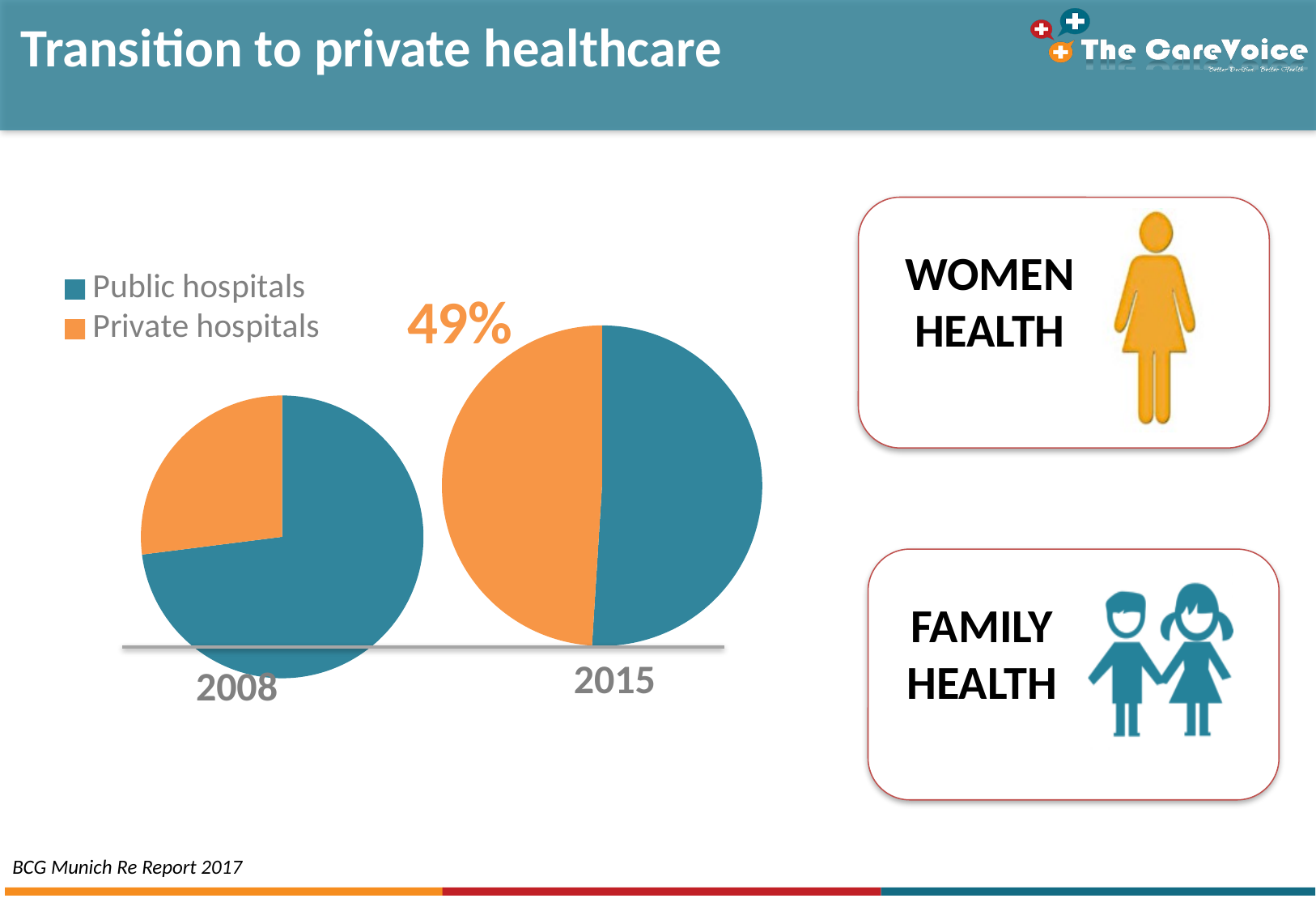
In the 2015 pie chart, what share is labelled for private hospitals? 49% Which colour represents private hospitals in the pie charts? Orange In the 2008 pie chart, which category has the smallest slice? Private hospitals Does the share of private hospitals rise or fall from 2008 to 2015? Rise Which year's pie chart carries the 49% label? 2015 How many pie charts are on the slide? 2 What kind of charts are shown on the slide? Pie charts How many series does the legend list? 2 In the 2015 pie chart, what share do public hospitals account for, given the private hospitals label? 51% Is the private hospitals share larger in the 2008 pie chart or the 2015 pie chart? 2015 In the 2008 pie chart, which category has the largest slice? Public hospitals